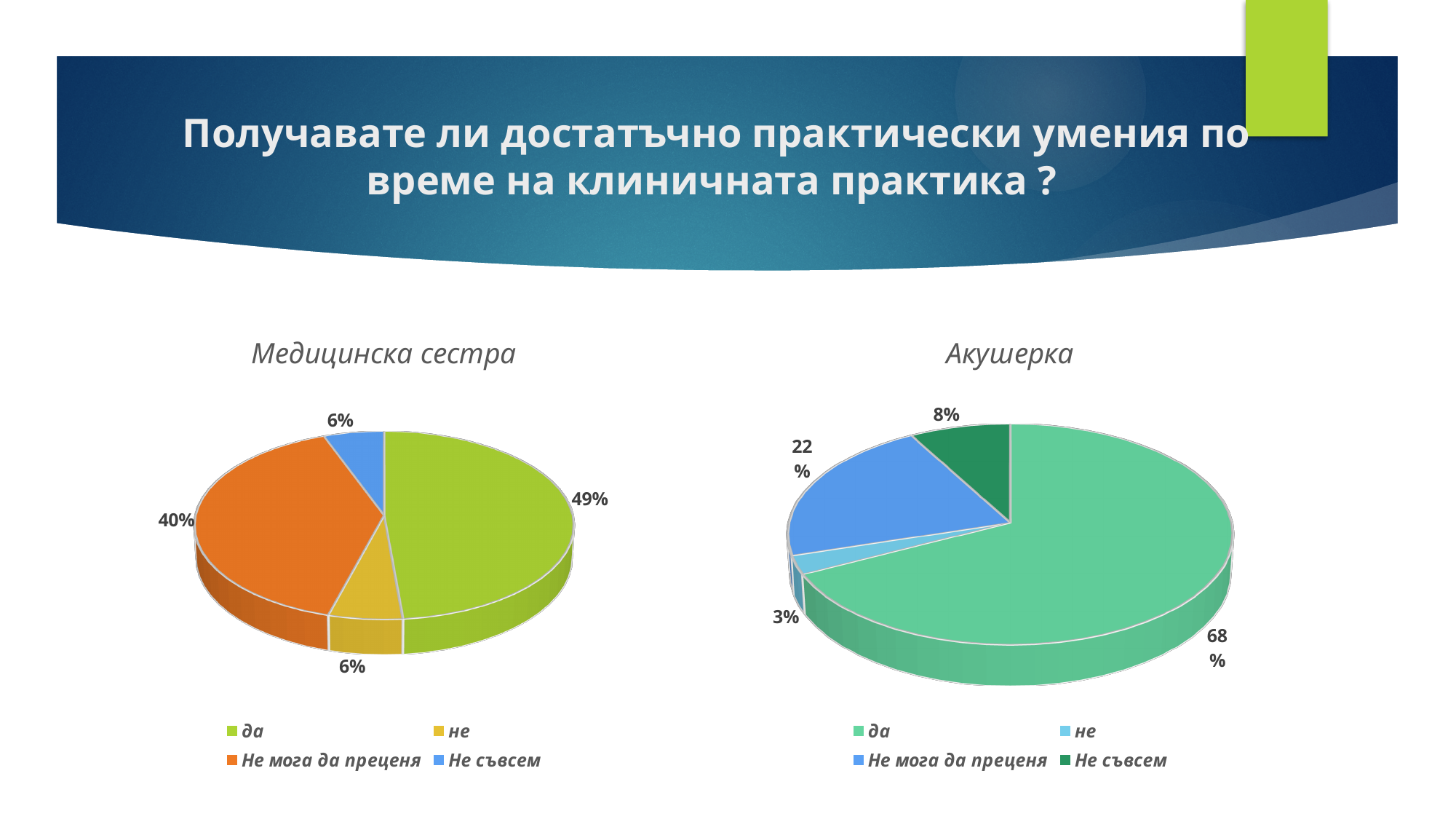
In the "Медицинска сестра" chart, what share of respondents answered "да"? 49% What type of chart is used on the slide? Pie chart What is the difference between the "да" share in the "Акушерка" chart and the "да" share in the "Медицинска сестра" chart? 19% In the "Акушерка" chart, what share of respondents answered "да"? 68% In the "Акушерка" chart, what share of respondents answered "Не съвсем"? 8% In the "Акушерка" chart, what share of respondents answered "не"? 3% In the "Медицинска сестра" chart, what share of respondents answered "Не мога да преценя"? 40% In the "Медицинска сестра" chart, which answer has the largest share? да In the "Акушерка" chart, which answer has the largest share? да Which chart has the larger share for "Не мога да преценя", "Медицинска сестра" or "Акушерка"? Медицинска сестра In the "Акушерка" chart, which answer has the smallest share? не How many answer categories does the legend of the "Акушерка" chart list? 4